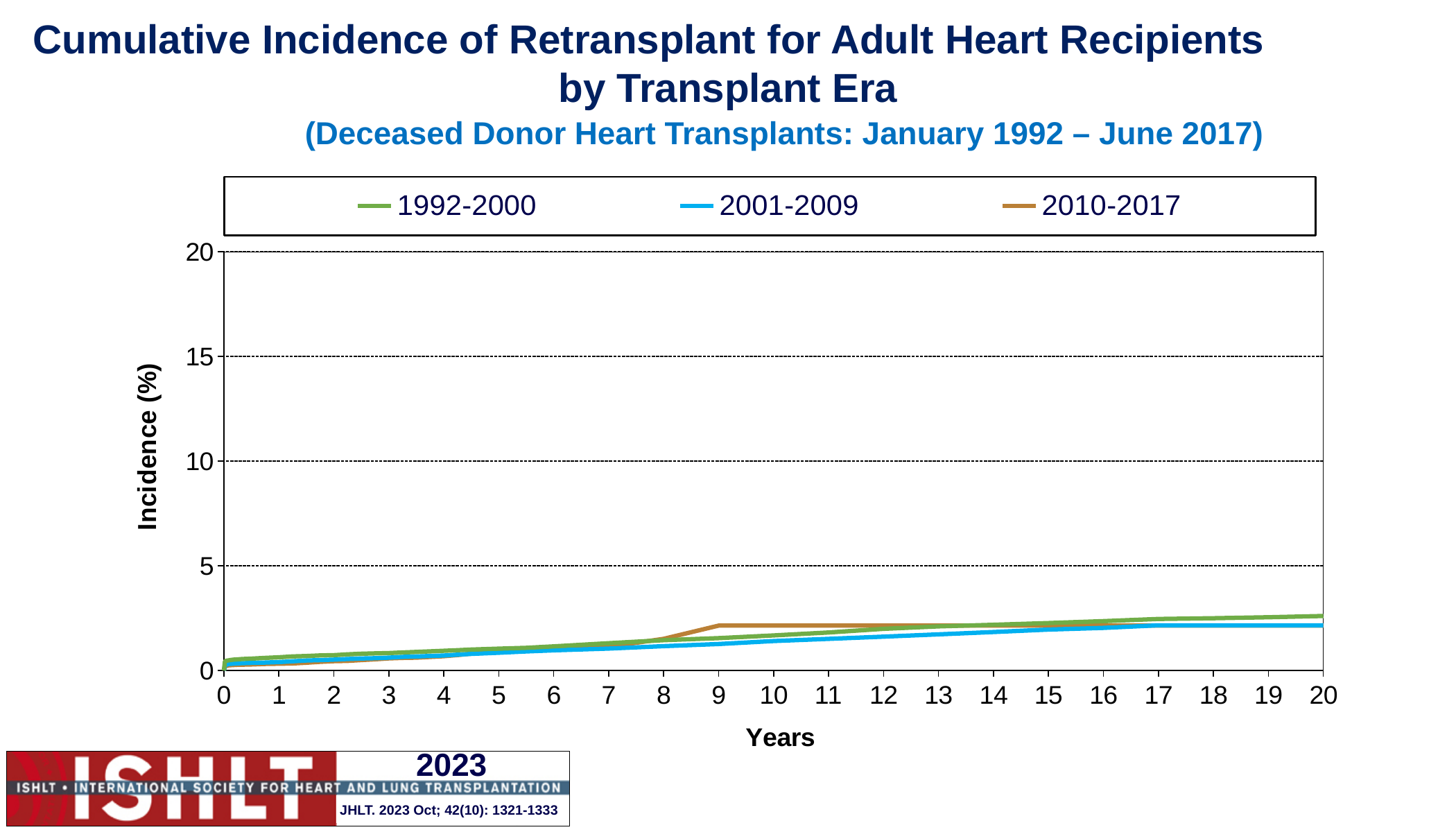
Is the value for the 2001-2009 era at 10 years greater or less than 5? less Is the value for the 2010-2017 era at 9 years greater or less than 5? less How many series does the legend list? 3 Which transplant eras are listed in the legend? 1992-2000, 2001-2009, 2010-2017 What is the label of the y axis? Incidence (%) Do the cumulative incidence values for the 1992-2000 era rise or fall as years increase? rise At 20 years, which era has the higher cumulative incidence, 1992-2000 or 2001-2009? 1992-2000 How many year tick marks are labelled on the x axis? 21 At 9 years, which era has the higher cumulative incidence, 2010-2017 or 2001-2009? 2010-2017 What is the highest value shown on the y axis? 20 What kind of chart is shown on the slide? line chart Is the value for the 1992-2000 era at 20 years greater or less than 5? less